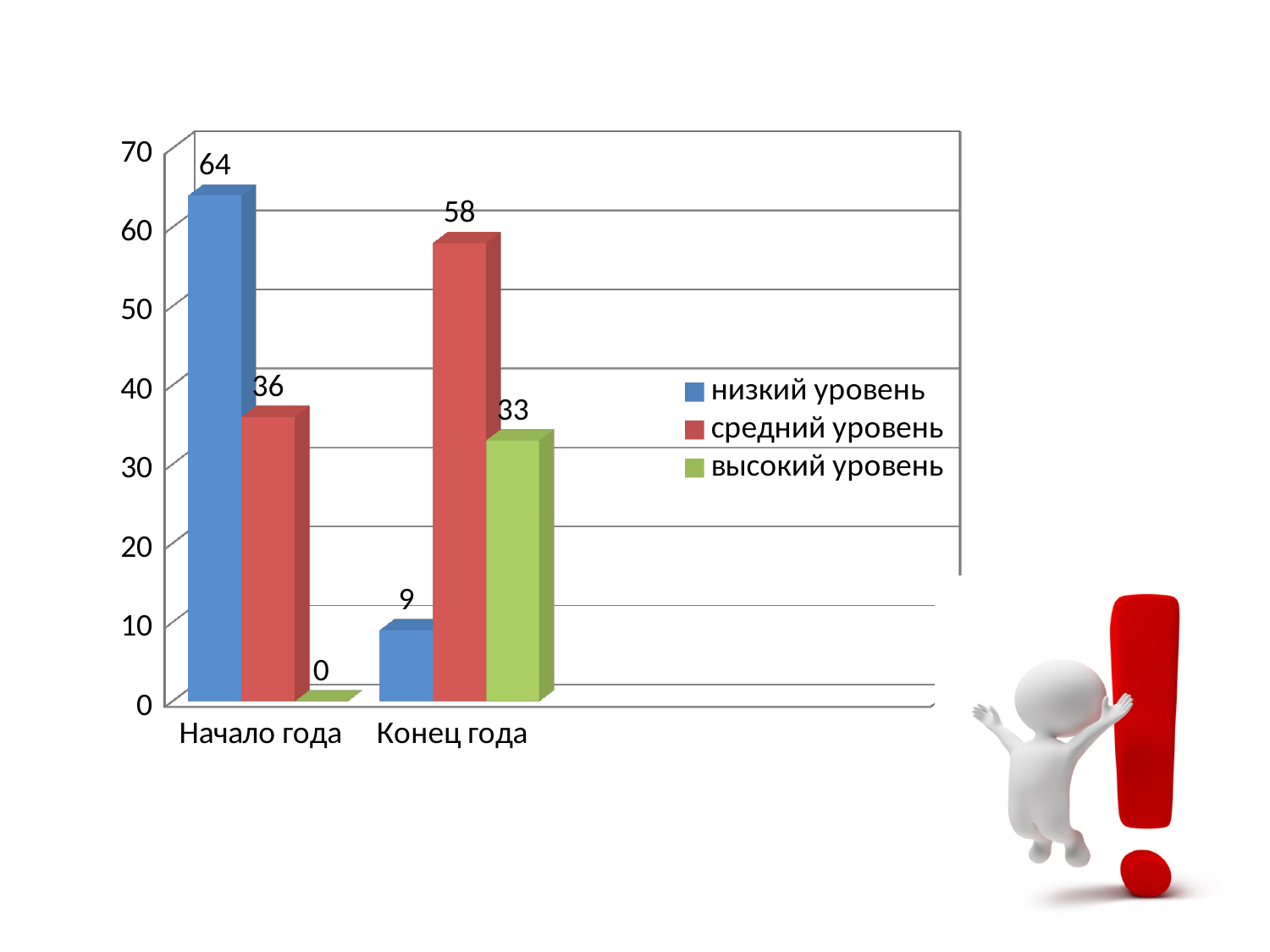
How many series does the legend list? 3 What is the value for низкий уровень at Конец года? 9 What is the value for средний уровень at Конец года? 58 Which series has the highest value at Начало года? низкий уровень What is the difference between the низкий уровень values at Начало года and Конец года? 55 Which series has the lowest value at Конец года? низкий уровень What kind of chart is shown on the slide? bar chart What is the value for высокий уровень at Начало года? 0 How many categories are shown on the x axis? 2 Does the value for высокий уровень rise or fall from Начало года to Конец года? rise Which is larger: средний уровень at Начало года or высокий уровень at Конец года? средний уровень at Начало года What is the value for низкий уровень at Начало года? 64